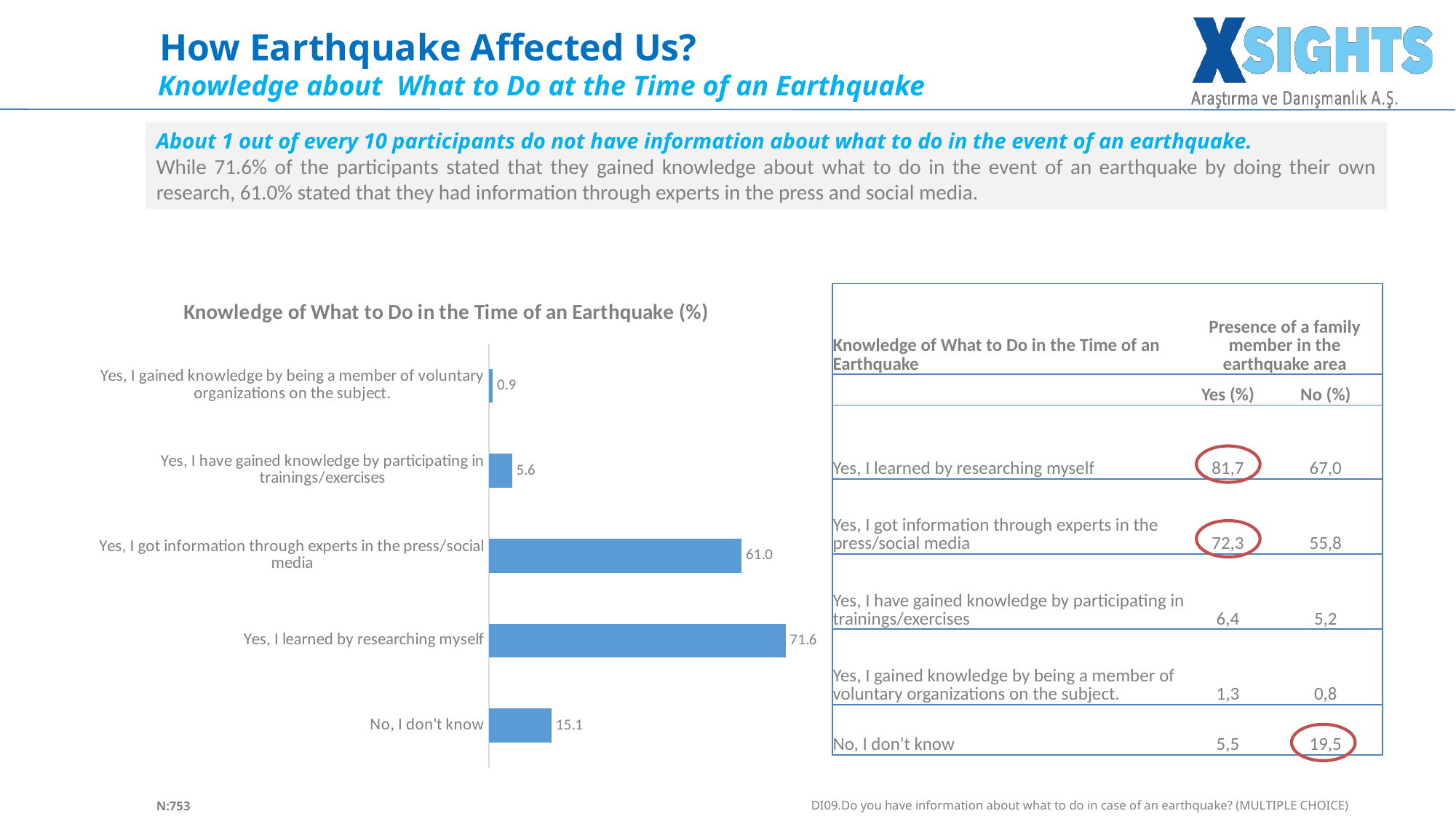
What is the value for "Yes, I got information through experts in the press/social media" in the chart? 61.0 What is the value for "Yes, I learned by researching myself" in the chart? 71.6 Which is larger: the value for "No, I don't know" or the value for "Yes, I have gained knowledge by participating in trainings/exercises"? No, I don't know What is the value for "No, I don't know" in the chart? 15.1 Which category has the lowest value in the chart? Yes, I gained knowledge by being a member of voluntary organizations on the subject. What is the value for "Yes, I have gained knowledge by participating in trainings/exercises" in the chart? 5.6 How many categories are shown in the chart? 5 Which category has the highest value in the chart? Yes, I learned by researching myself What kind of chart is shown on the slide? Bar chart What is the difference between the values for "No, I don't know" and "Yes, I gained knowledge by being a member of voluntary organizations on the subject."? 14.2 What is the title of the chart? Knowledge of What to Do in the Time of an Earthquake (%) What is the difference between the values for "Yes, I learned by researching myself" and "Yes, I got information through experts in the press/social media"? 10.6